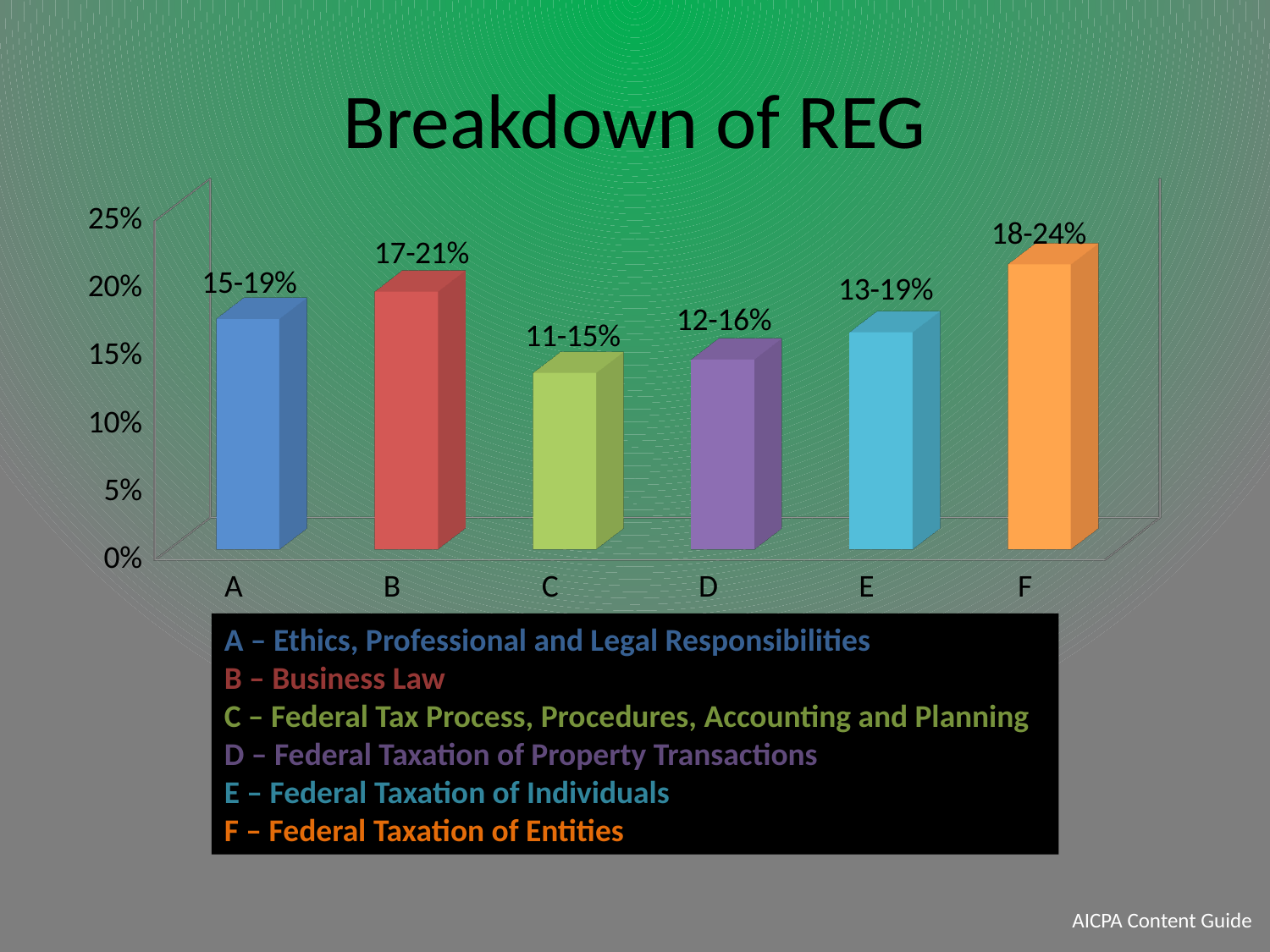
What is the data label shown for category A? 15-19% Which category has the tallest bar? F How many categories are plotted in the chart? 6 What is the title of the chart? Breakdown of REG Which bar is taller, A or B? B What kind of chart is shown on the slide? bar chart What is the data label shown for category F? 18-24% What is the data label shown for category D? 12-16% According to the legend, what does category E stand for? Federal Taxation of Individuals What is the data label shown for category B? 17-21% Which category has the shortest bar? C What is the data label shown for category C? 11-15%